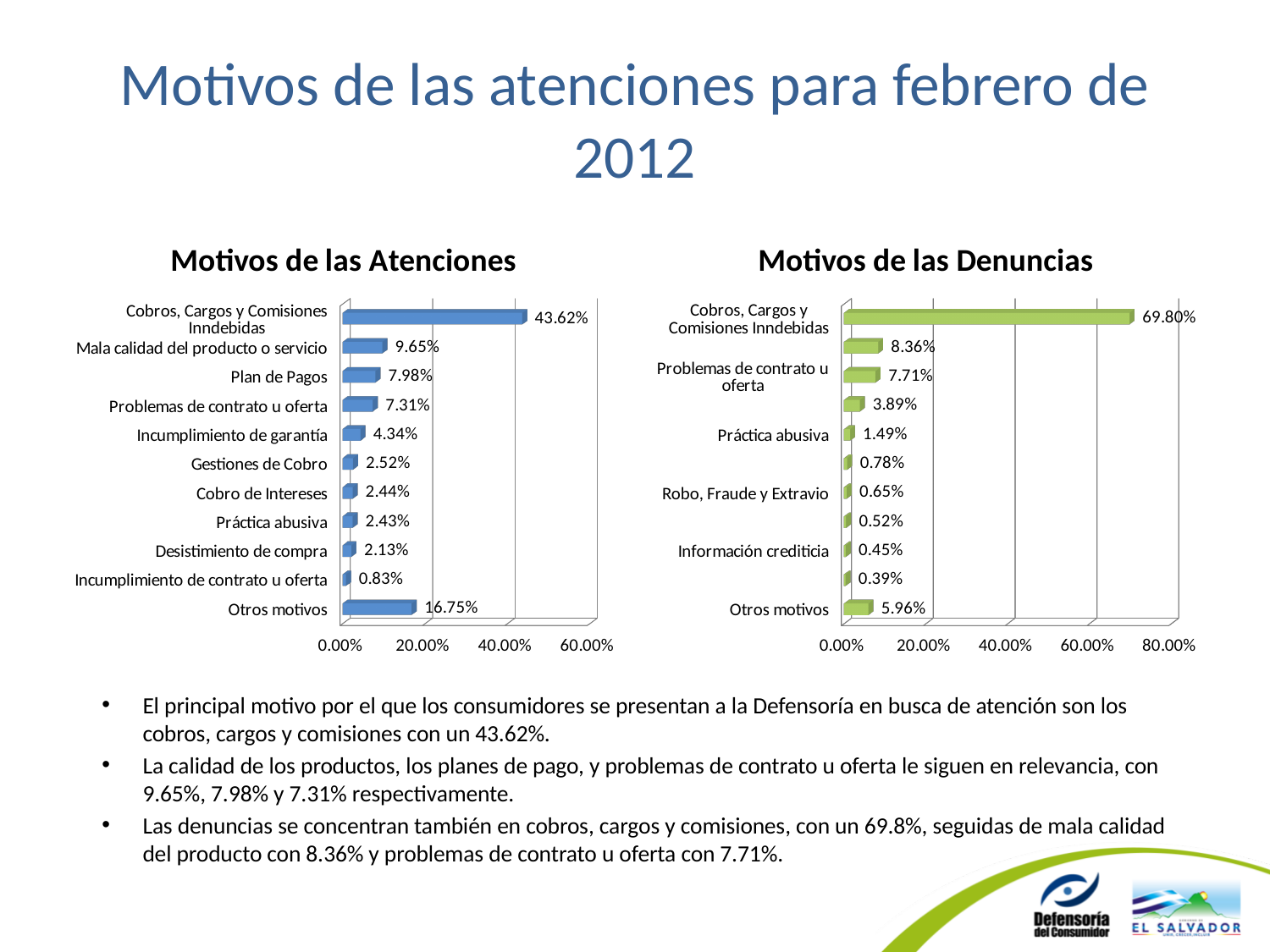
In the 'Motivos de las Denuncias' chart, which is larger: Práctica abusiva or Robo, Fraude y Extravio? Práctica abusiva In the 'Motivos de las Atenciones' chart, which category has the lowest value? Incumplimiento de contrato u oferta In the 'Motivos de las Atenciones' chart, what is the value for Cobros, Cargos y Comisiones Inndebidas? 43.62% In the 'Motivos de las Atenciones' chart, how many categories are shown? 11 What type of chart is 'Motivos de las Denuncias'? Bar chart In the 'Motivos de las Atenciones' chart, what is the value for Incumplimiento de garantía? 4.34% In the 'Motivos de las Atenciones' chart, what is the difference between Mala calidad del producto o servicio and Plan de Pagos? 1.67% In the 'Motivos de las Denuncias' chart, what is the value for Cobros, Cargos y Comisiones Inndebidas? 69.80% In the 'Motivos de las Denuncias' chart, what is the difference between Cobros, Cargos y Comisiones Inndebidas and Problemas de contrato u oferta? 62.09% In the 'Motivos de las Denuncias' chart, what is the value for Otros motivos? 5.96% In the 'Motivos de las Denuncias' chart, what is the value for Problemas de contrato u oferta? 7.71% In the 'Motivos de las Atenciones' chart, what is the value for Otros motivos? 16.75%